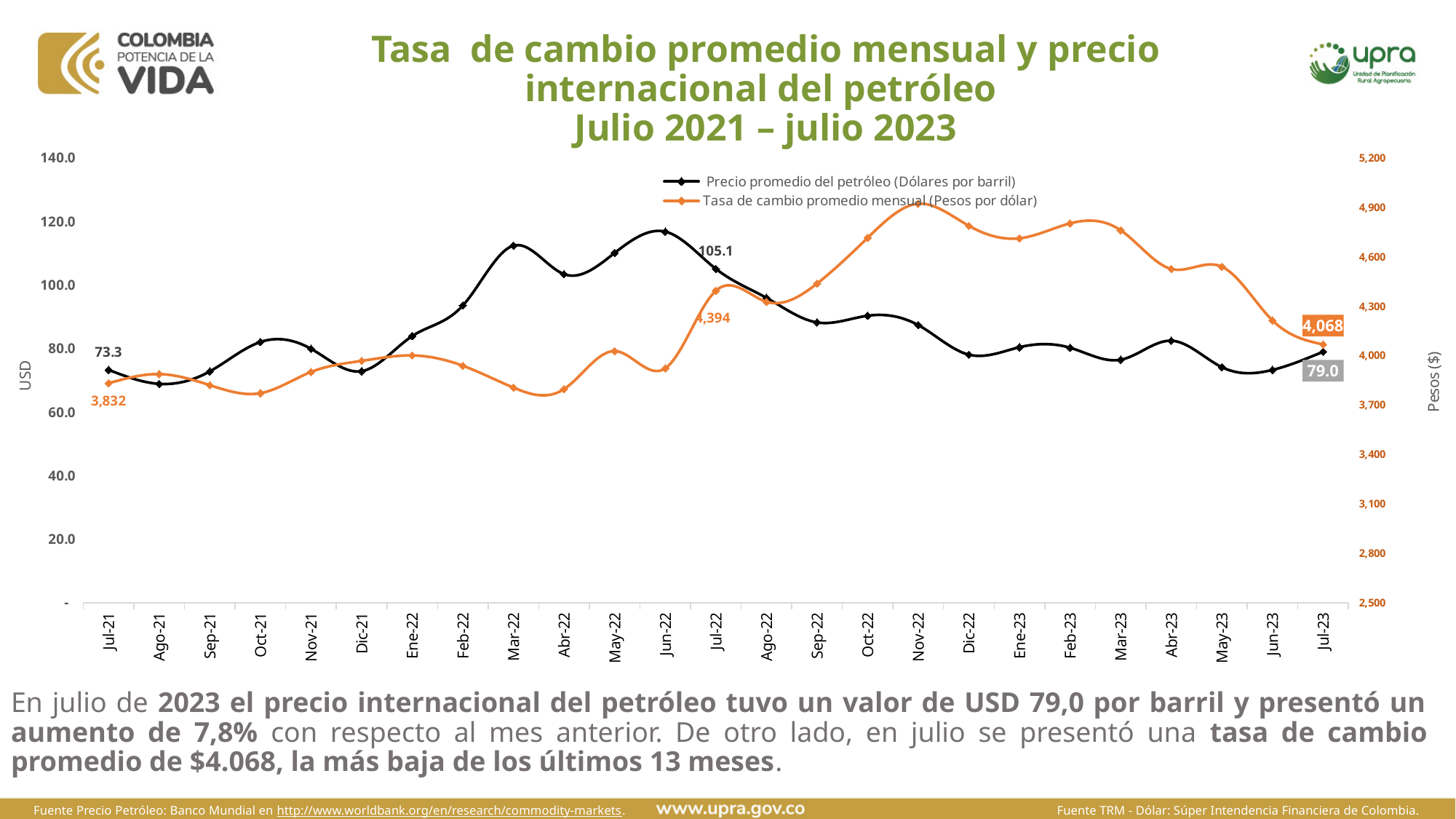
What was the monthly average exchange rate (Tasa de cambio promedio mensual) in Jul-21? 3,832 What was the average oil price (Precio promedio del petróleo) in Jul-23? 79.0 What was the monthly average exchange rate (Tasa de cambio promedio mensual) in Jul-23? 4,068 What type of chart is shown on the slide? Line chart How many series does the legend list? 2 What is the difference between the exchange rate in Jul-22 (4,394) and in Jul-23 (4,068)? 326 By how much did the average oil price in Jul-22 exceed the value in Jul-21? 31.8 What was the average oil price (Precio promedio del petróleo) in Jul-21? 73.3 Is the average oil price in Mar-22 greater or less than 100.0? greater What was the average oil price (Precio promedio del petróleo) in Jul-22? 105.1 In which month did the monthly average exchange rate reach its highest point? Nov-22 Which month had the higher average oil price, Jul-21 or Jul-23? Jul-23